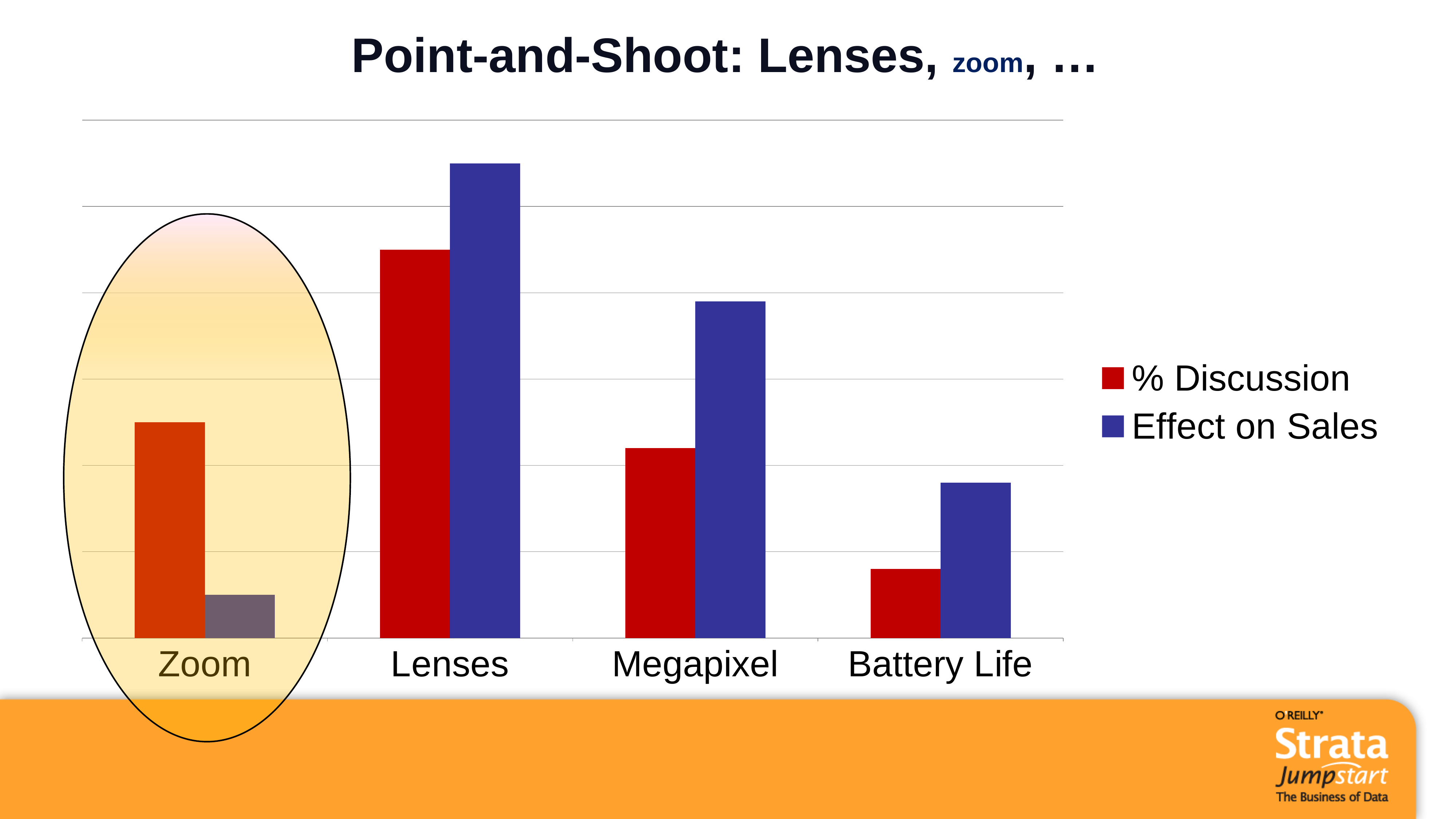
Going from Lenses to Battery Life along the x axis, does the Effect on Sales value rise or fall? Fall What kind of chart is shown on the slide? Bar chart Which category has the highest Effect on Sales value? Lenses Which category has the highest % Discussion value? Lenses For Megapixel, which is larger: % Discussion or Effect on Sales? Effect on Sales Which category has the lowest Effect on Sales value? Zoom Which category is highlighted with an oval on the slide? Zoom For Zoom, which is larger: % Discussion or Effect on Sales? % Discussion Which category has the lowest % Discussion value? Battery Life Which has the larger Effect on Sales value: Megapixel or Battery Life? Megapixel How many categories are shown on the x axis? 4 How many series does the legend list? 2